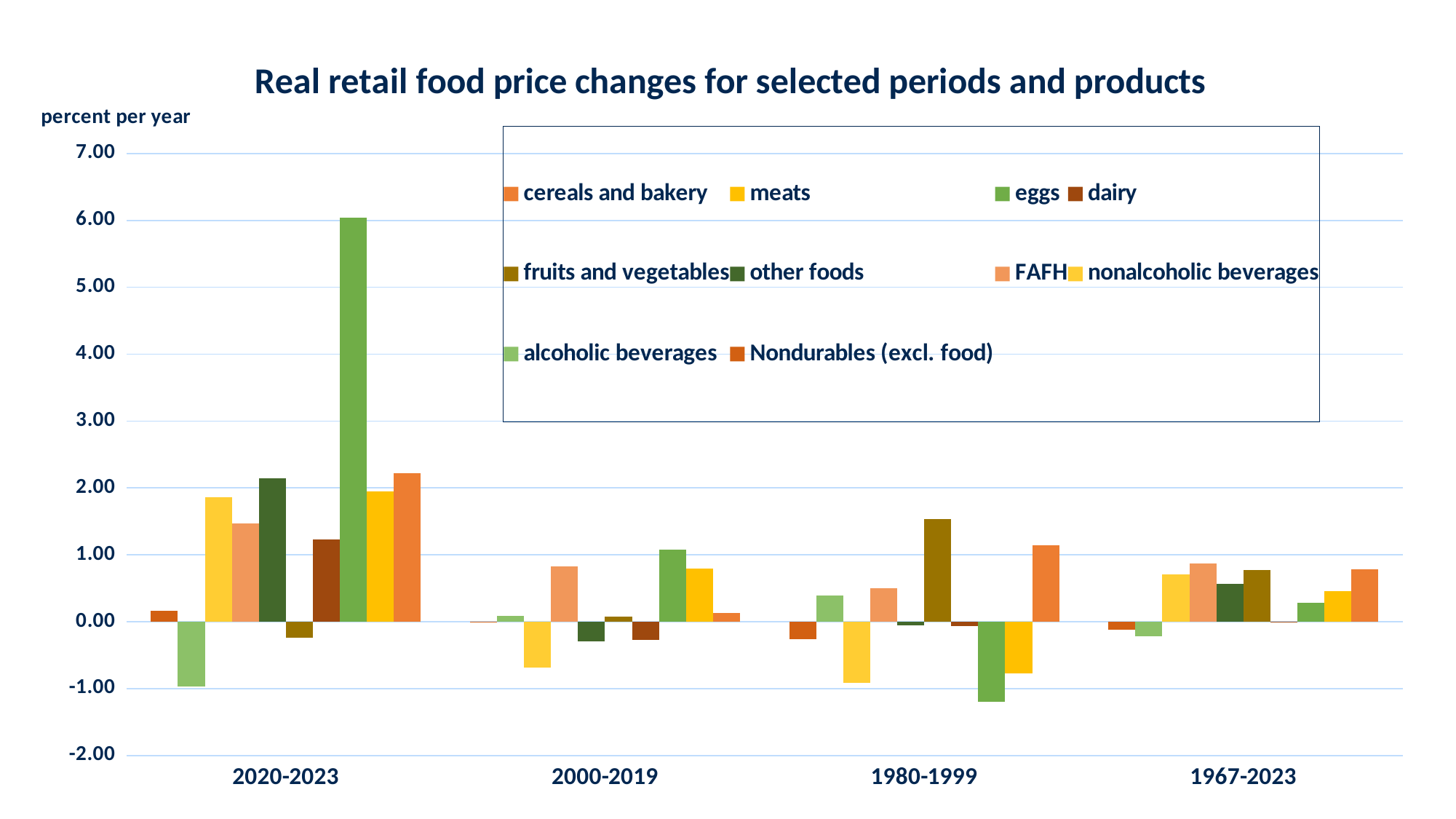
How many series does the legend list? 10 Is the value for alcoholic beverages in 2020-2023 greater or less than -0.50? less Which is larger in the 2020-2023 period: eggs or dairy? eggs What kind of chart is shown on the slide? bar chart What unit is given for the y axis? percent per year Which series has the highest value in the 2020-2023 period? eggs Which series has the lowest value in the 1980-1999 period? eggs Is the value for fruits and vegetables in 1980-1999 greater or less than 1.00? greater Is the value for Nondurables (excl. food) in 2020-2023 greater or less than 2.00? less How many time periods are shown on the x axis? 4 Which series has the lowest value in the 2020-2023 period? alcoholic beverages